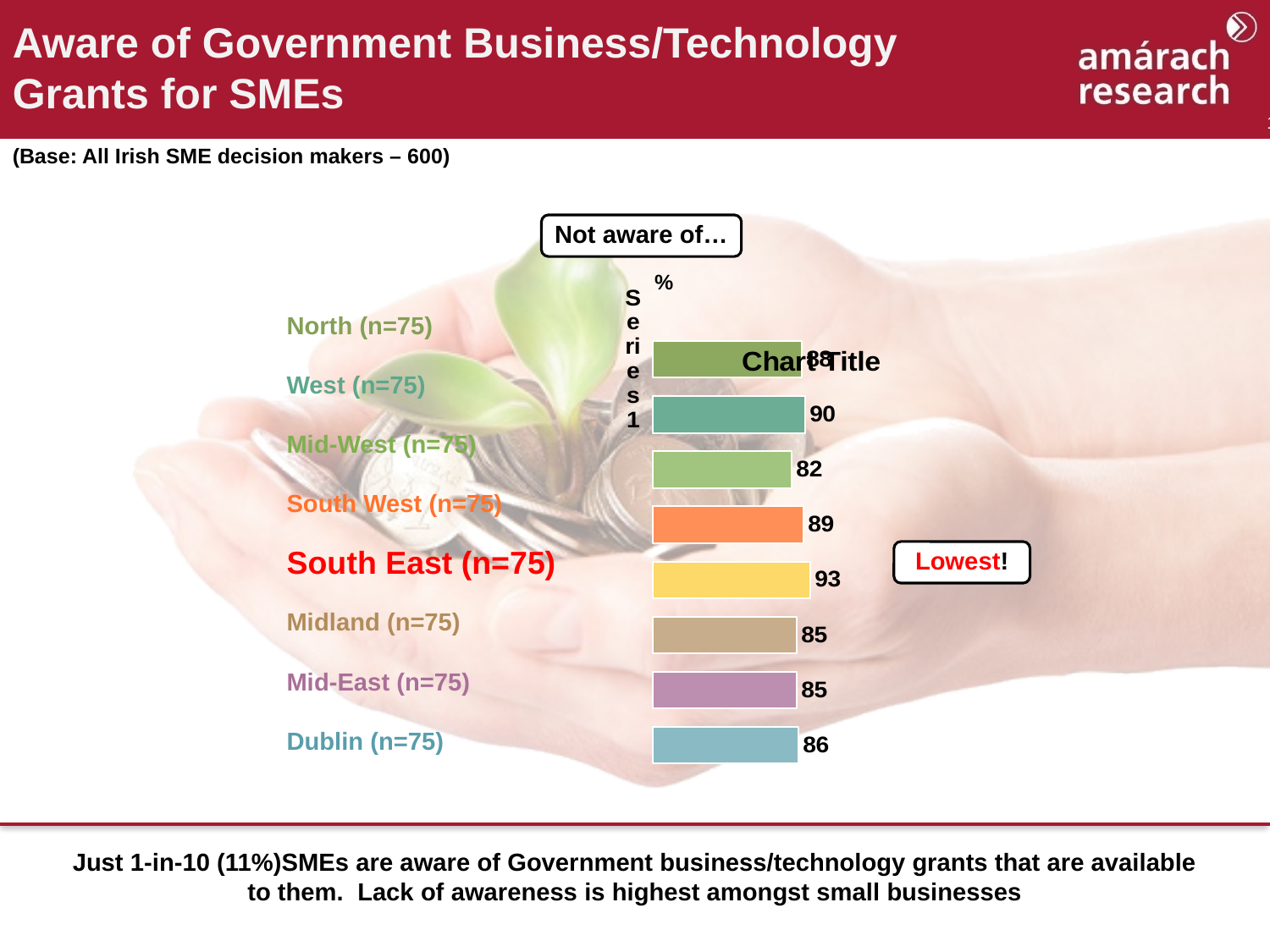
Which region has the highest value in the chart? South East (n=75) What is the value for Dublin (n=75)? 86 What type of chart is shown on the slide? bar chart What is the value for West (n=75)? 90 What is the difference between the values for South East (n=75) and Mid-West (n=75)? 11 What is the value for South East (n=75)? 93 What is the value for Mid-West (n=75)? 82 Which is larger, the value for West (n=75) or the value for Dublin (n=75)? West (n=75) Which region does the 'Lowest!' callout point to? South East (n=75) What is the value for Midland (n=75)? 85 Which region has the lowest value in the chart? Mid-West (n=75) How many regions are plotted in the chart? 8